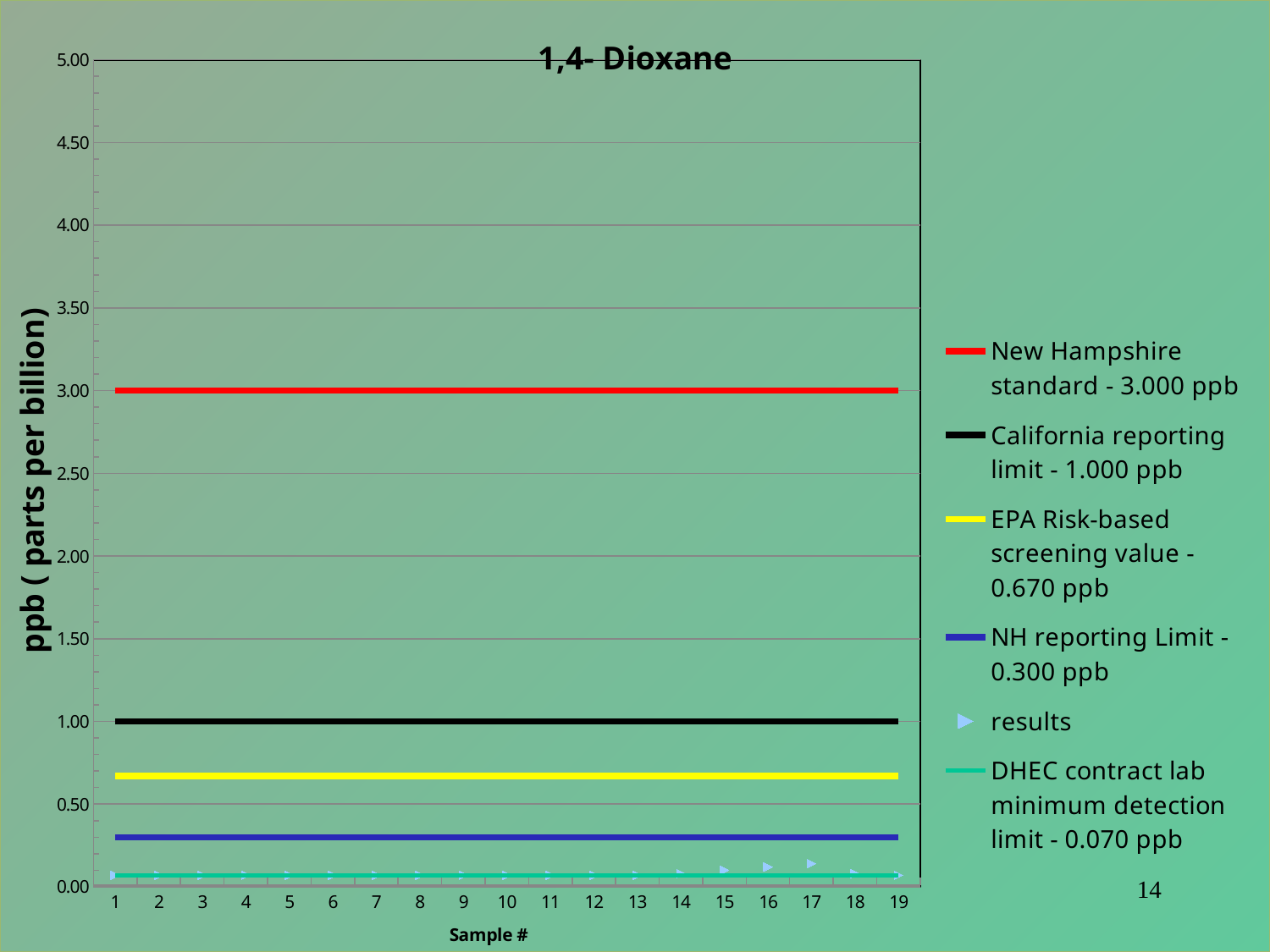
Is the results value for sample 17 greater or less than 0.50? less Which of the horizontal reference lines has the highest value? New Hampshire standard - 3.000 ppb What value does the legend give for the California reporting limit? 1.000 ppb How many sample numbers are shown along the x axis? 19 Which is larger, the EPA Risk-based screening value or the NH reporting Limit? EPA Risk-based screening value What kind of chart is shown on the slide? line chart What is the difference between the New Hampshire standard and the California reporting limit? 2.000 ppb How many series does the legend list? 6 What value does the legend give for the DHEC contract lab minimum detection limit? 0.070 ppb What value does the legend give for the EPA Risk-based screening value? 0.670 ppb What value does the legend give for the New Hampshire standard? 3.000 ppb What is the title of the chart? 1,4- Dioxane